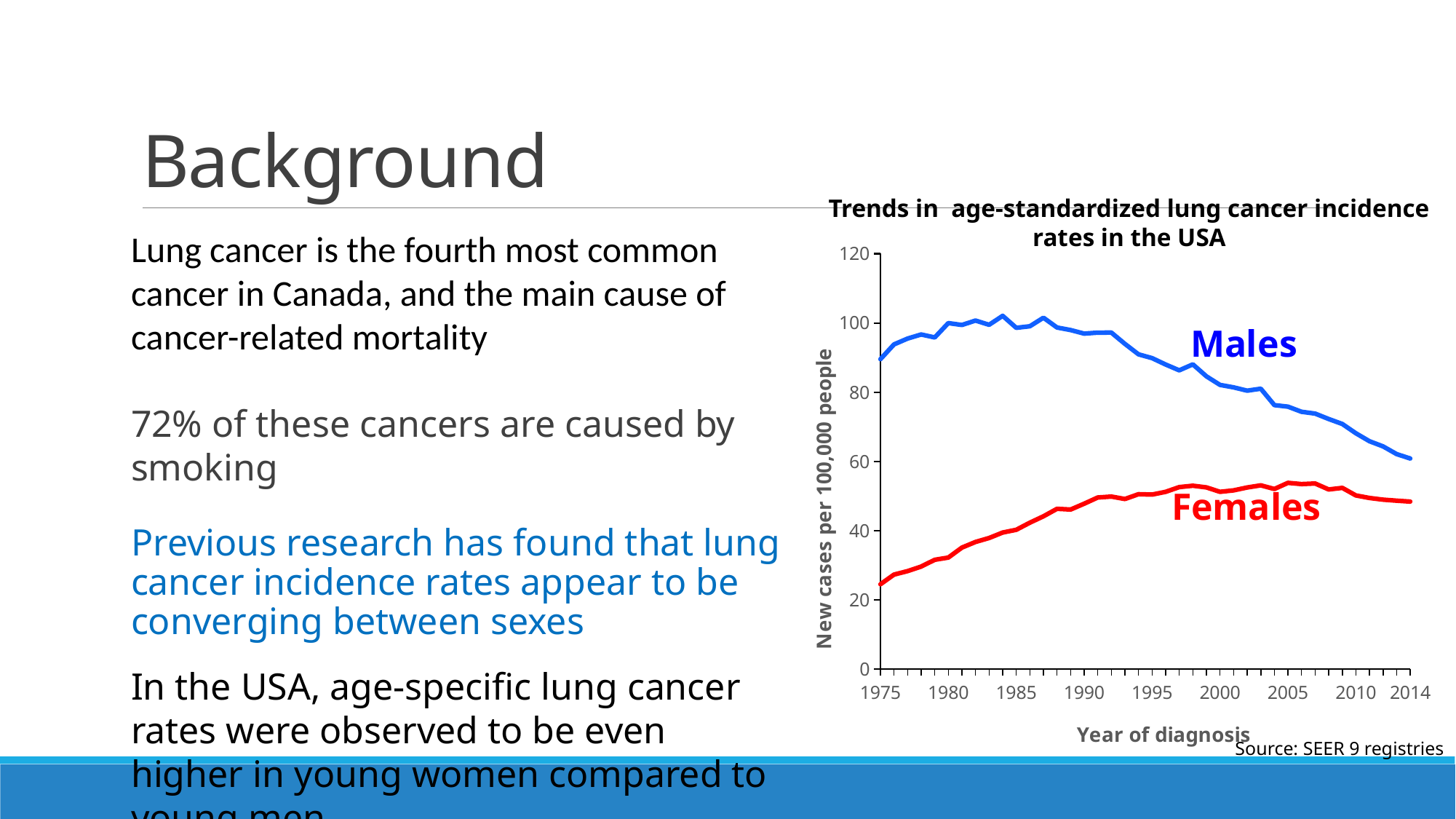
Is the value for Males in 1975 greater or less than 80? greater What kind of chart is shown on the slide? line chart Is the value for Males in 1985 greater or less than 80? greater Is the value for Males in 2014 greater or less than 80? less How many series are plotted on the chart? 2 What is the title of the chart? Trends in age-standardized lung cancer incidence rates in the USA Does the Females line rise or fall between 1975 and 1990? rise What is the label of the y axis? New cases per 100,000 people Does the Males line rise or fall between 1990 and 2014? fall In 2014, which series has the higher value, Males or Females? Males